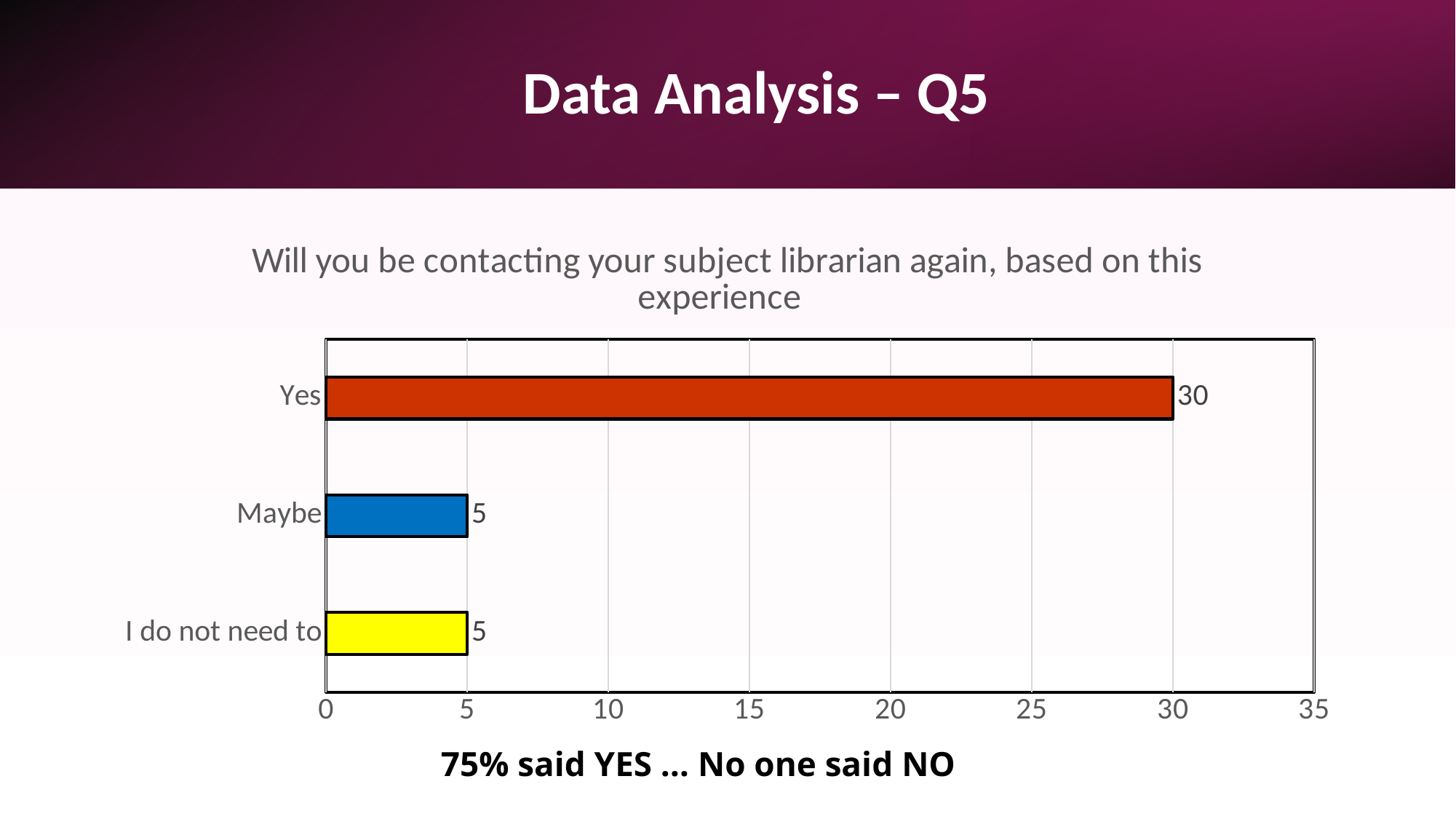
What colour is the bar for Maybe? blue What is the title of the chart? Will you be contacting your subject librarian again, based on this experience What is the value for Yes? 30 What kind of chart is shown on the slide? bar chart Which is larger, the value for Yes or the value for I do not need to? Yes Is the value for Yes greater or less than 25? greater What is the value for Maybe? 5 How many categories are shown in the chart? 3 What is the maximum value shown on the x axis? 35 Which category has the highest value? Yes What is the value for I do not need to? 5 What is the difference between the values for Yes and Maybe? 25